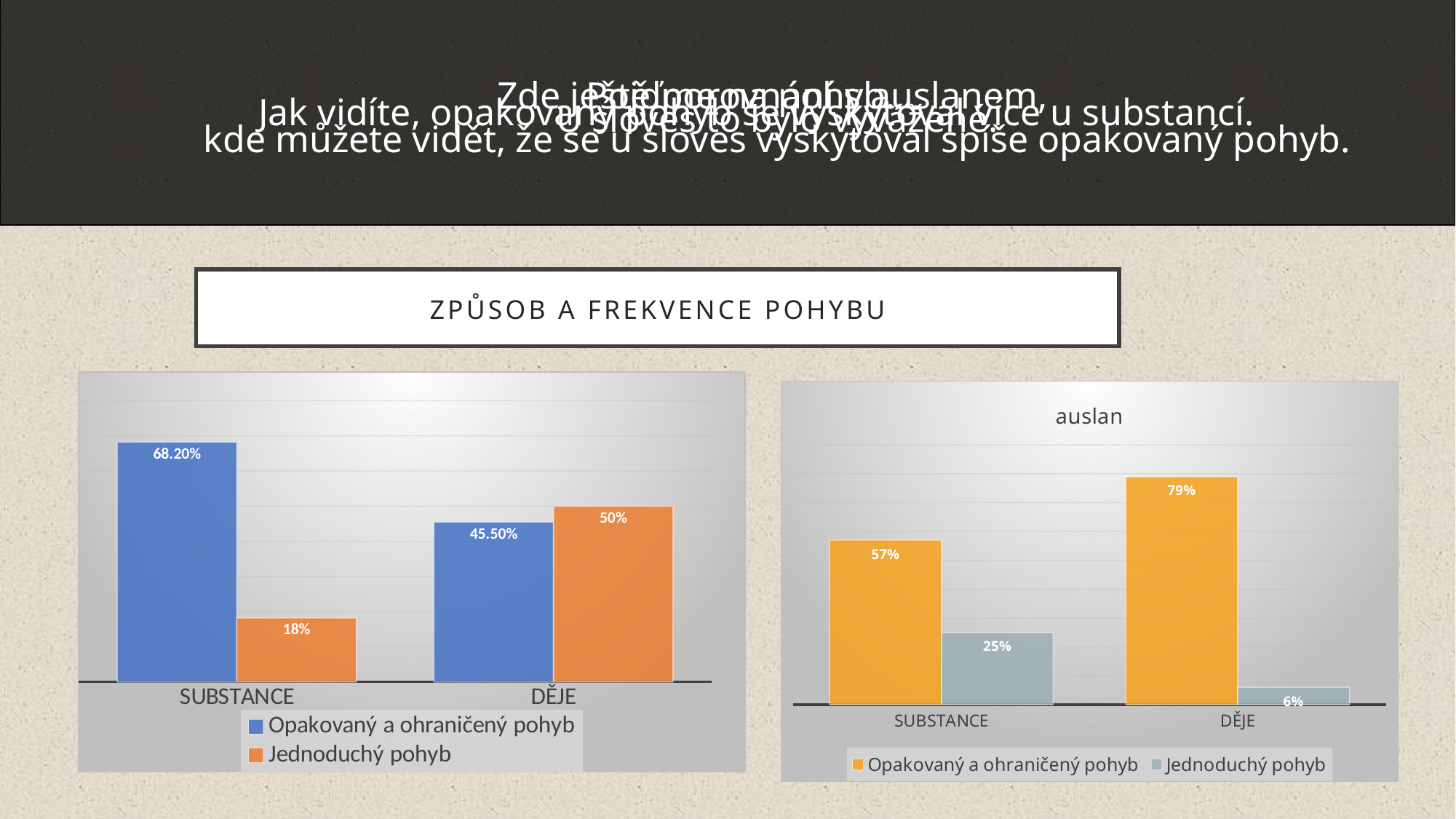
In the left chart, what is the value for Opakovaný a ohraničený pohyb for SUBSTANCE? 68.20% In the left chart, what is the difference between Opakovaný a ohraničený pohyb and Jednoduchý pohyb for SUBSTANCE? 50% What kind of chart is the chart titled auslan? Bar chart In the left chart, what is the value for Jednoduchý pohyb for SUBSTANCE? 18% In the chart titled auslan, what is the value for Jednoduchý pohyb for SUBSTANCE? 25% In the left chart, how many series does the legend list? 2 In the chart titled auslan, what is the difference between Opakovaný a ohraničený pohyb and Jednoduchý pohyb for DĚJE? 73% In the chart titled auslan, what is the value for Opakovaný a ohraničený pohyb for DĚJE? 79% In the left chart, which series has the higher value for DĚJE? Jednoduchý pohyb In the chart titled auslan, which category has the lowest value for Jednoduchý pohyb? DĚJE In the chart titled auslan, what is the value for Jednoduchý pohyb for DĚJE? 6% In the left chart, what is the value for Jednoduchý pohyb for DĚJE? 50%